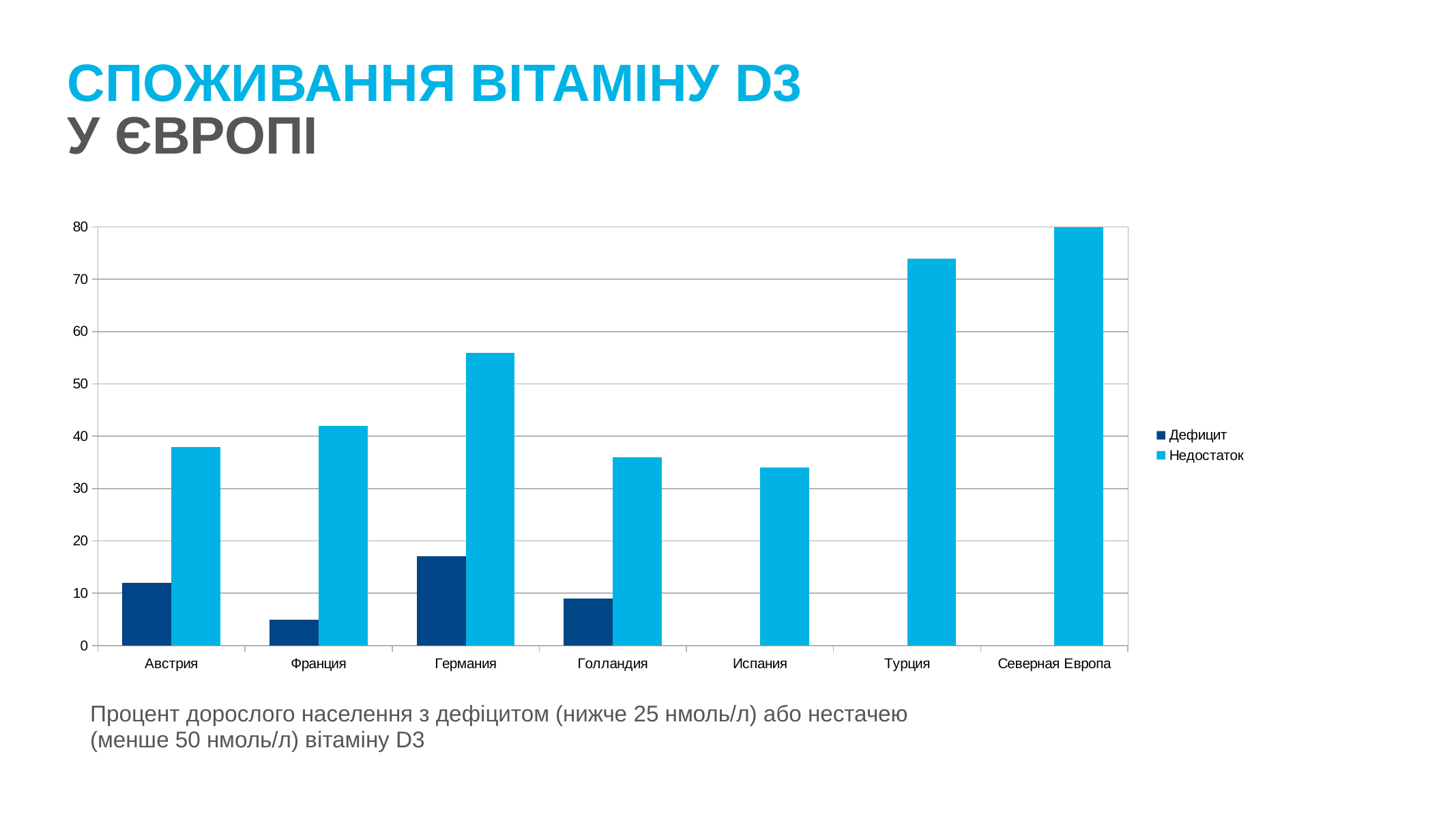
What are the two legend entries of the chart? Дефицит and Недостаток Is the Дефицит value for Франция greater or less than 10? less What kind of chart is shown on the slide? bar chart Is the Недостаток value for Турция greater or less than 70? greater What is the Недостаток value for Северная Европа? 80 How many countries or regions are shown on the x axis? 7 How many series does the legend list? 2 Is the Недостаток value for Германия greater or less than 50? greater Which category has the lowest Недостаток value? Испания Which category has the highest Недостаток value? Северная Европа Which is larger: the Недостаток value for Франция or for Голландия? Франция Which category has the highest Дефицит value? Германия